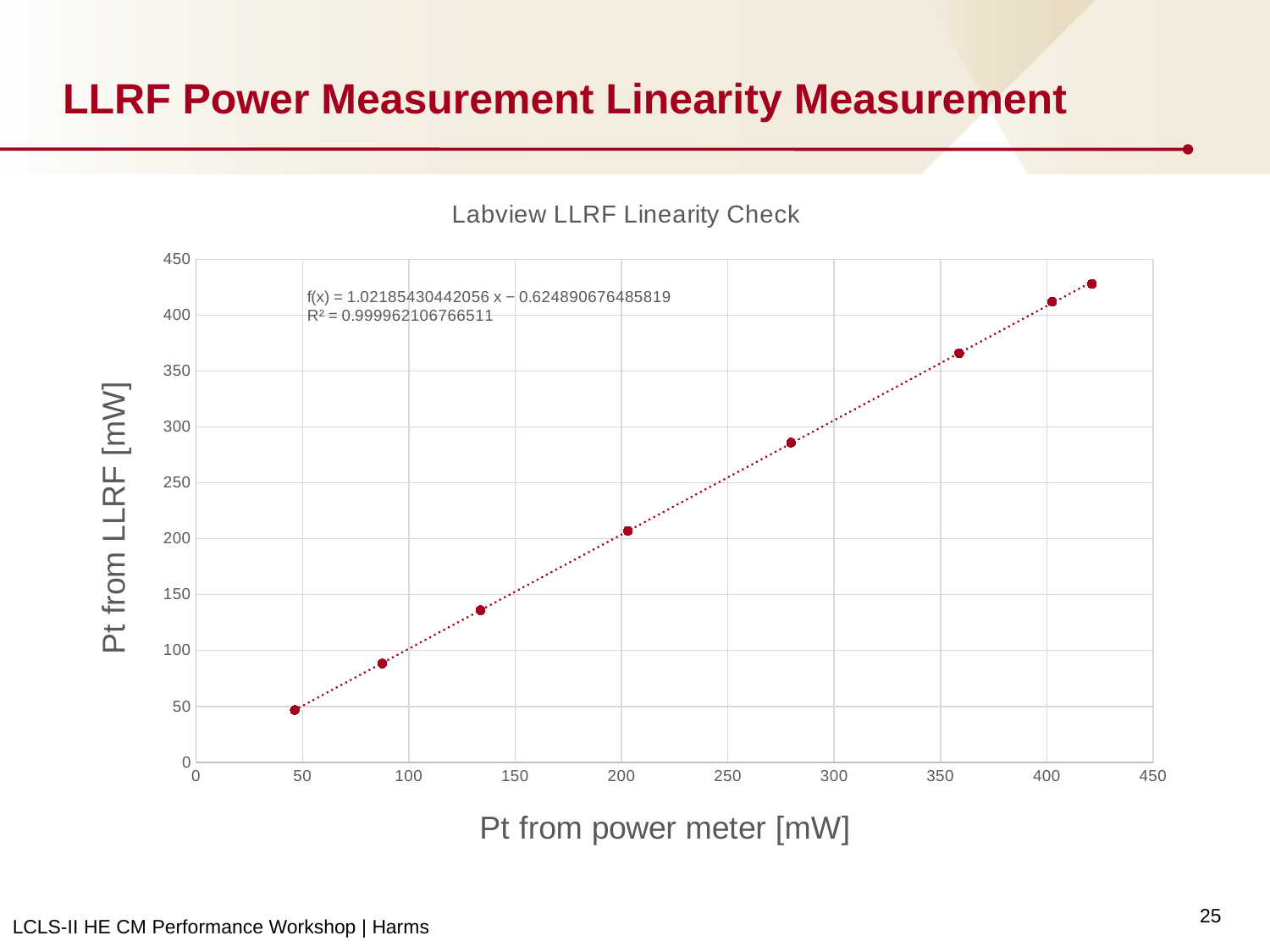
Which plotted point has the highest Pt from LLRF value: the one near 420 mW or the one near 360 mW on the power meter axis? The one near 420 mW Do the plotted values of Pt from LLRF rise or fall as Pt from power meter increases? Rise What is the maximum value shown on the y axis of the chart? 450 Is the Pt from power meter value of the rightmost plotted point greater or less than 400 mW? greater Is the Pt from LLRF value for the point near 280 mW on the power meter axis greater or less than 250 mW? greater What is the slope of the fitted line f(x) shown on the chart? 1.02185430442056 What kind of chart is shown on the slide? Scatter plot with a trendline Is the Pt from LLRF value of the highest plotted point greater or less than 400 mW? greater How many data points are plotted in the Labview LLRF Linearity Check chart? 8 What is the title of the chart? Labview LLRF Linearity Check What is the R² value shown on the chart? R² = 0.999962106766511